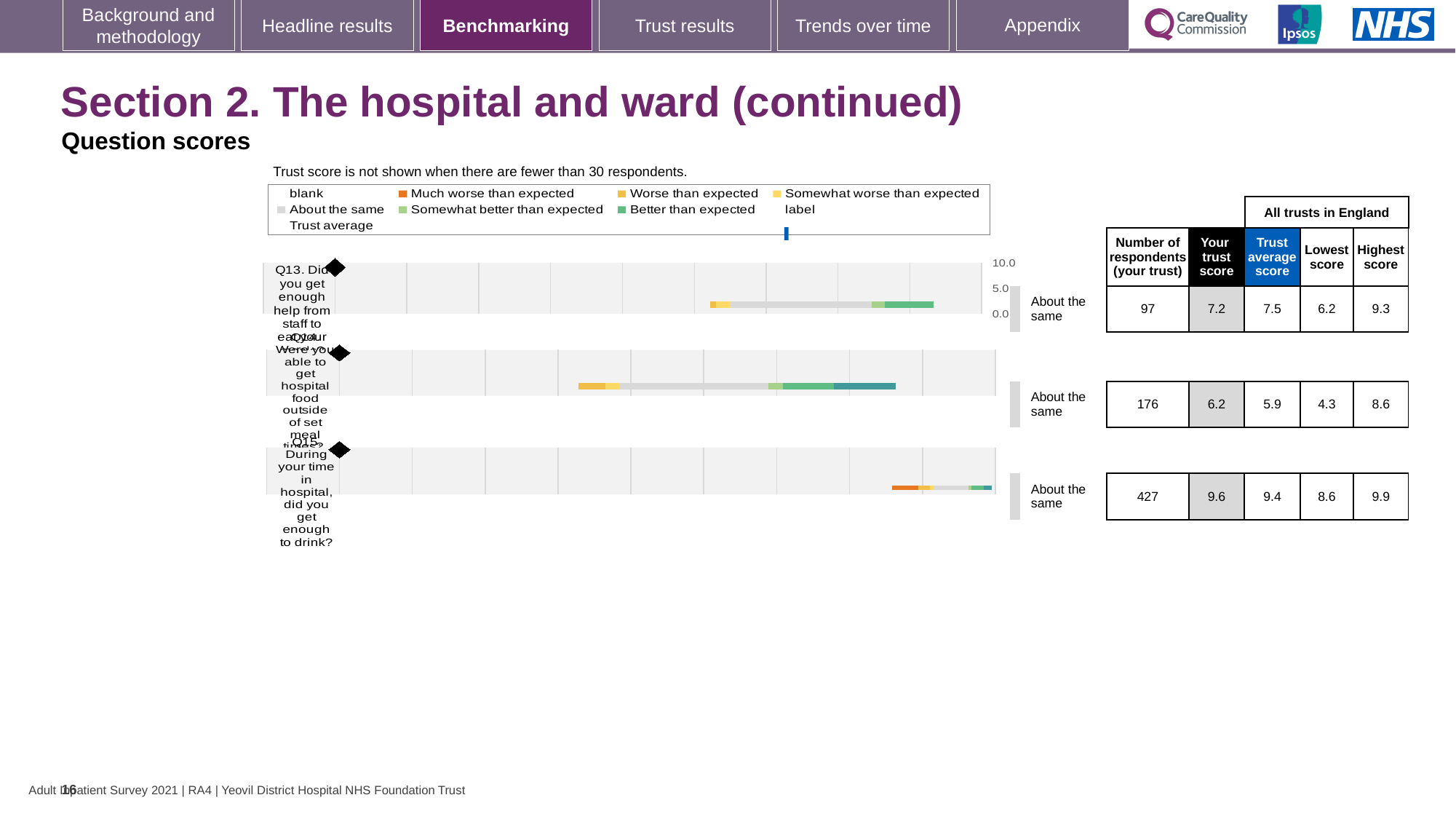
Which question has the lowest 'Your trust score'? Q14 For Q13, which is larger: your trust score or the trust average score? Trust average score How many respondents answered Q15 (During your time in hospital, did you get enough to drink?) at your trust? 427 What is the highest score across all trusts in England for Q14? 8.6 What is the 'Trust average score' for Q14 (Were you able to get hospital food outside of set meal times?)? 5.9 What benchmark rating is shown next to the bar for Q13? About the same How many questions (Q13, Q14, Q15) are plotted on the slide? 3 What is the difference between the trust average score and your trust score for Q14? 0.3 What is the difference between the highest score and the lowest score for Q15? 1.3 Which question has the highest 'Your trust score'? Q15 What kind of chart is used to show the question scores on this slide? bar chart What is the 'Your trust score' value for Q13 (Did you get enough help from staff to eat your meals?)? 7.2